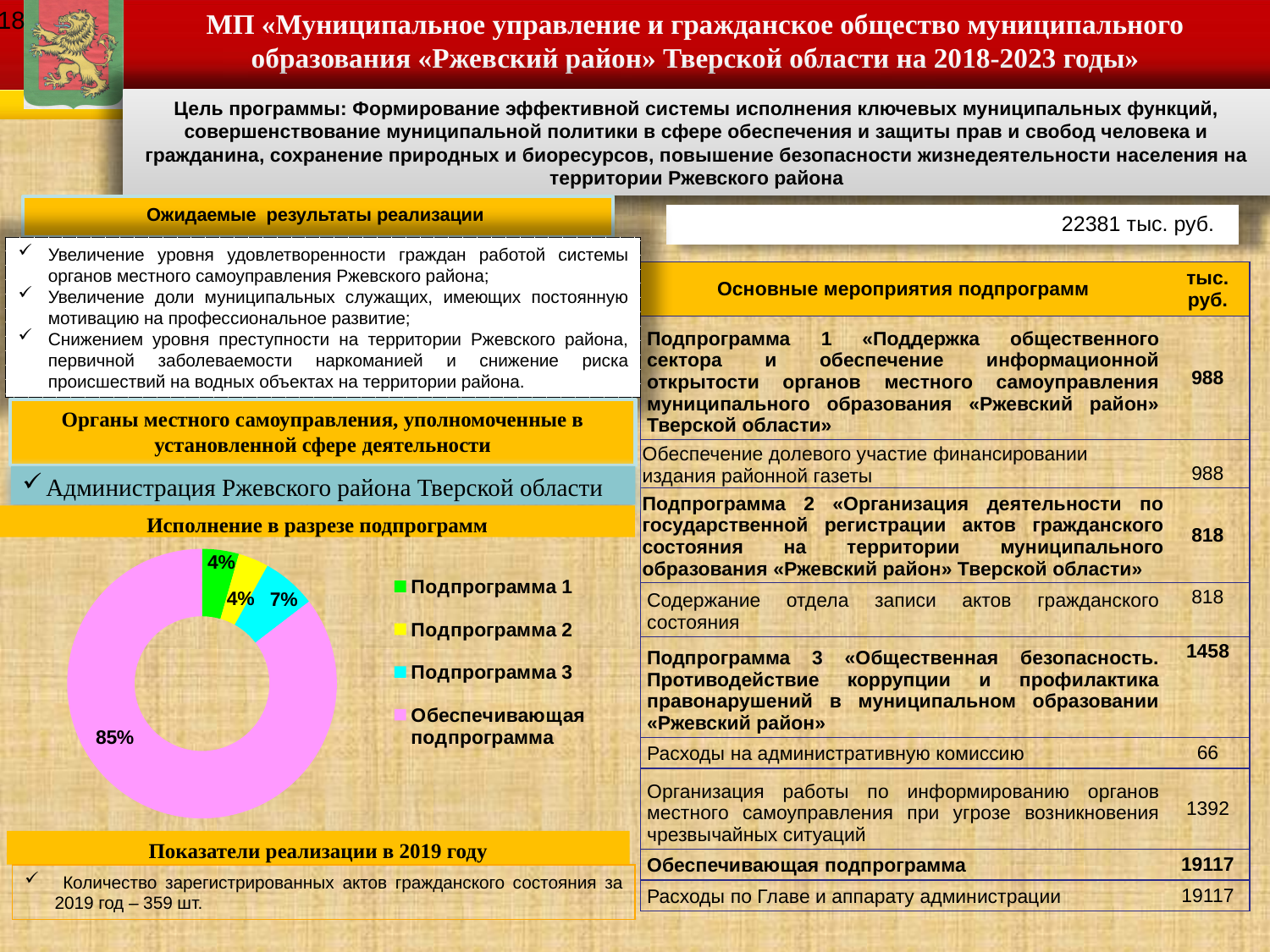
What percentage is shown for «Подпрограмма 3» in the doughnut chart? 7% What colour represents «Обеспечивающая подпрограмма» in the doughnut chart? Pink What percentage is shown for «Подпрограмма 2» in the doughnut chart? 4% What is the difference in percentage points between «Обеспечивающая подпрограмма» and «Подпрограмма 3» in the doughnut chart? 78 How many entries does the legend of the doughnut chart list? 4 What share of the doughnut chart does «Обеспечивающая подпрограмма» account for? 85% What percentage is shown for «Подпрограмма 1» in the doughnut chart? 4% Which is larger in the doughnut chart: «Подпрограмма 3» or «Подпрограмма 1»? Подпрограмма 3 Which category has the largest share in the doughnut chart? Обеспечивающая подпрограмма What type of chart is shown under the heading «Исполнение в разрезе подпрограмм»? Doughnut (pie) chart What colour represents «Подпрограмма 1» in the doughnut chart? Green How many categories are shown in the doughnut chart? 4